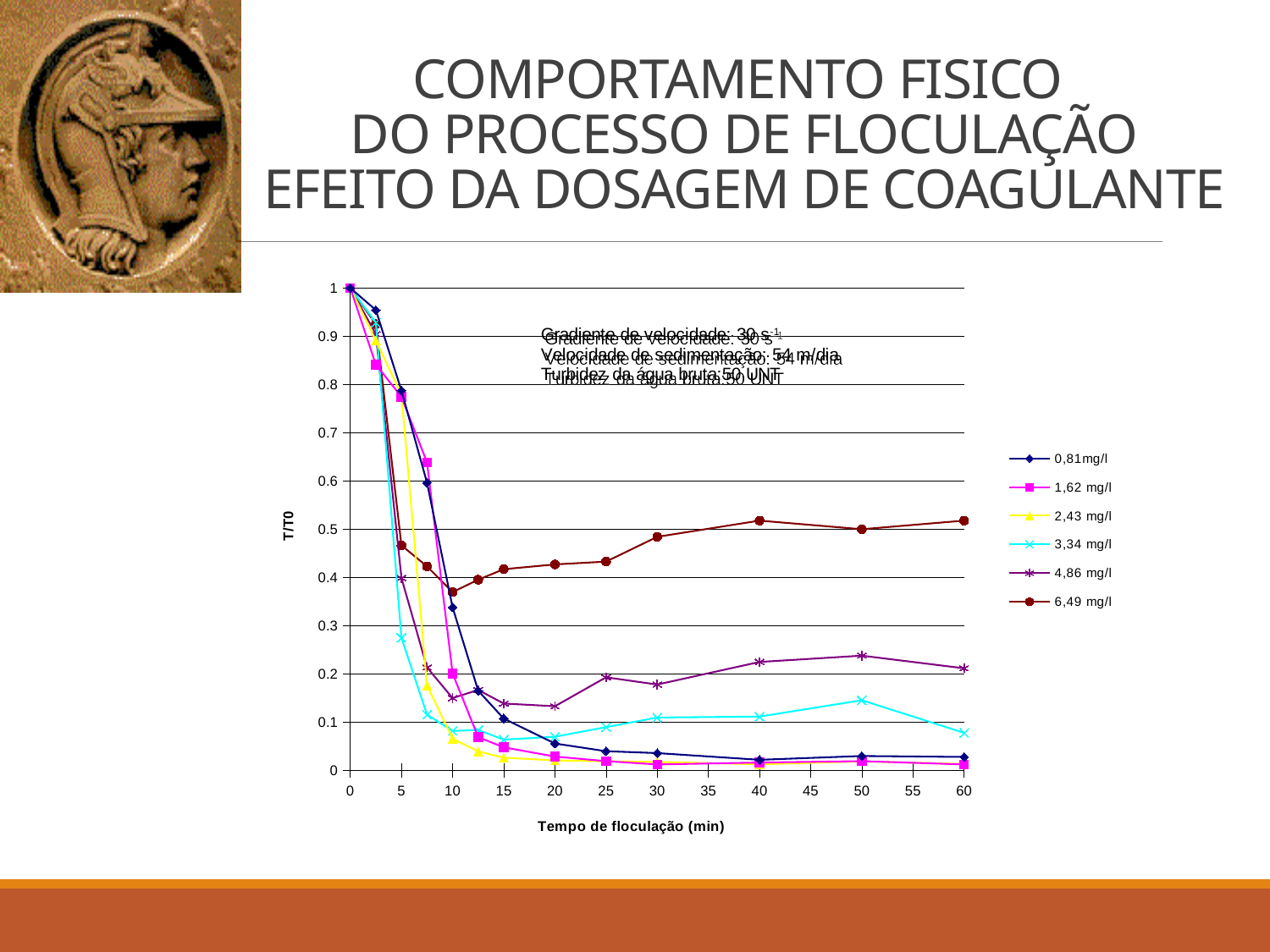
What is the title of the x axis? Tempo de floculação (min) Is the T/T0 value for the 0,81 mg/l series at 10 min greater or less than 0.5? less What is the T/T0 value of all series at time 0 min? 1 Which series has the highest T/T0 value at 30 min? 6,49 mg/l What is the title of the y axis? T/T0 Is the T/T0 value for the 4,86 mg/l series at 60 min greater or less than 0.1? greater Is the T/T0 value for the 6,49 mg/l series at 60 min greater or less than 0.4? greater At 40 min, which series has the larger T/T0 value, 4,86 mg/l or 3,34 mg/l? 4,86 mg/l Does the T/T0 value for the 6,49 mg/l series rise or fall between 10 min and 60 min? rise What kind of chart is shown on the slide? line chart How many series does the legend list? 6 Which series has the highest T/T0 value at 60 min? 6,49 mg/l